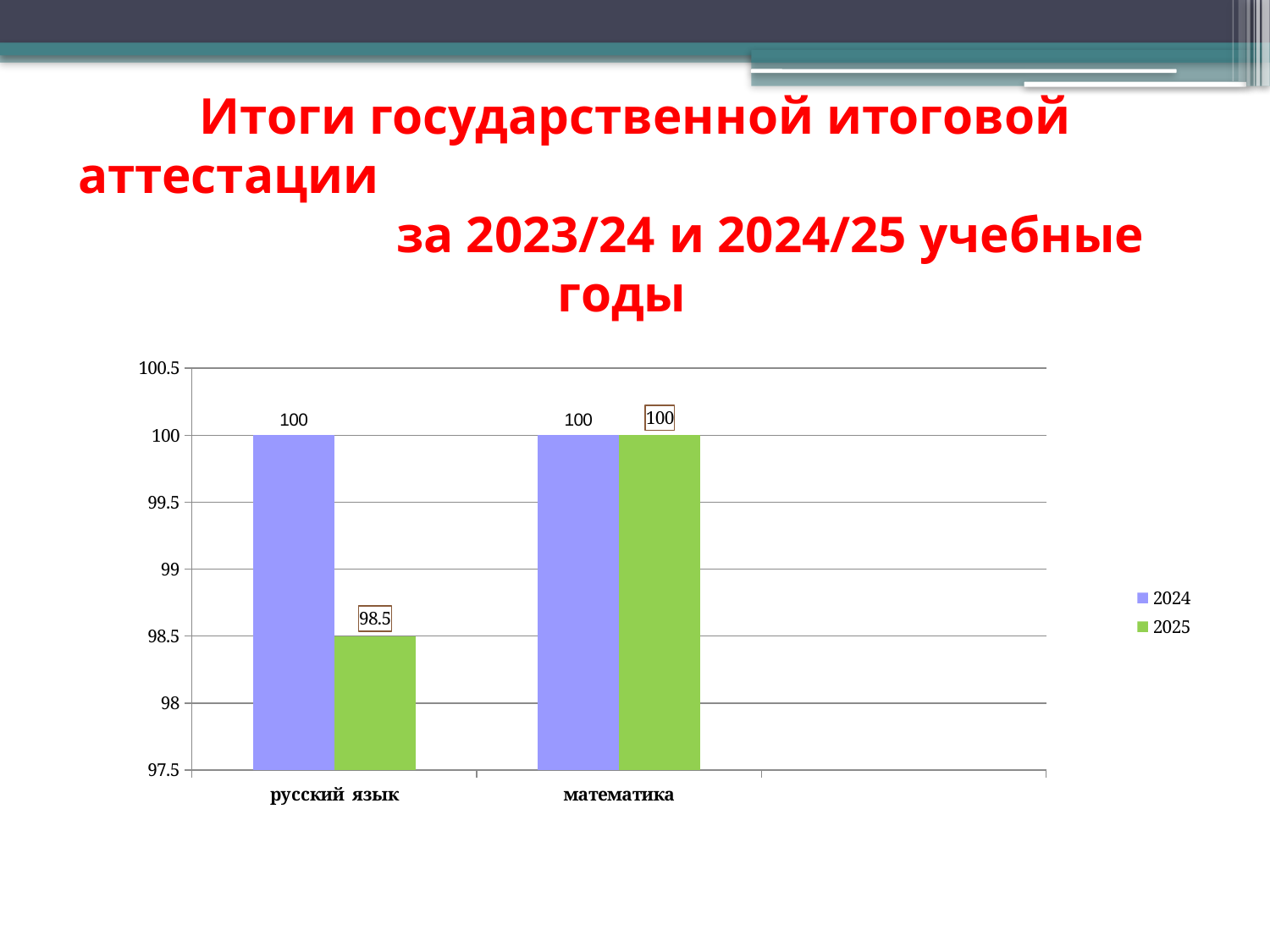
How many categories are shown on the x axis? 2 Which category has the lowest value in the 2025 series? русский язык What colour are the bars for the 2025 series? green What is the value for математика in the 2024 series? 100 How many series does the legend list? 2 What is the difference between the 2024 and 2025 values for русский язык? 1.5 What is the value for русский язык in the 2025 series? 98.5 What is the value for математика in the 2025 series? 100 What kind of chart is shown on the slide? bar chart For русский язык, which series has the larger value, 2024 or 2025? 2024 What is the value for русский язык in the 2024 series? 100 Is the 2025 value for русский язык greater or less than 99? less